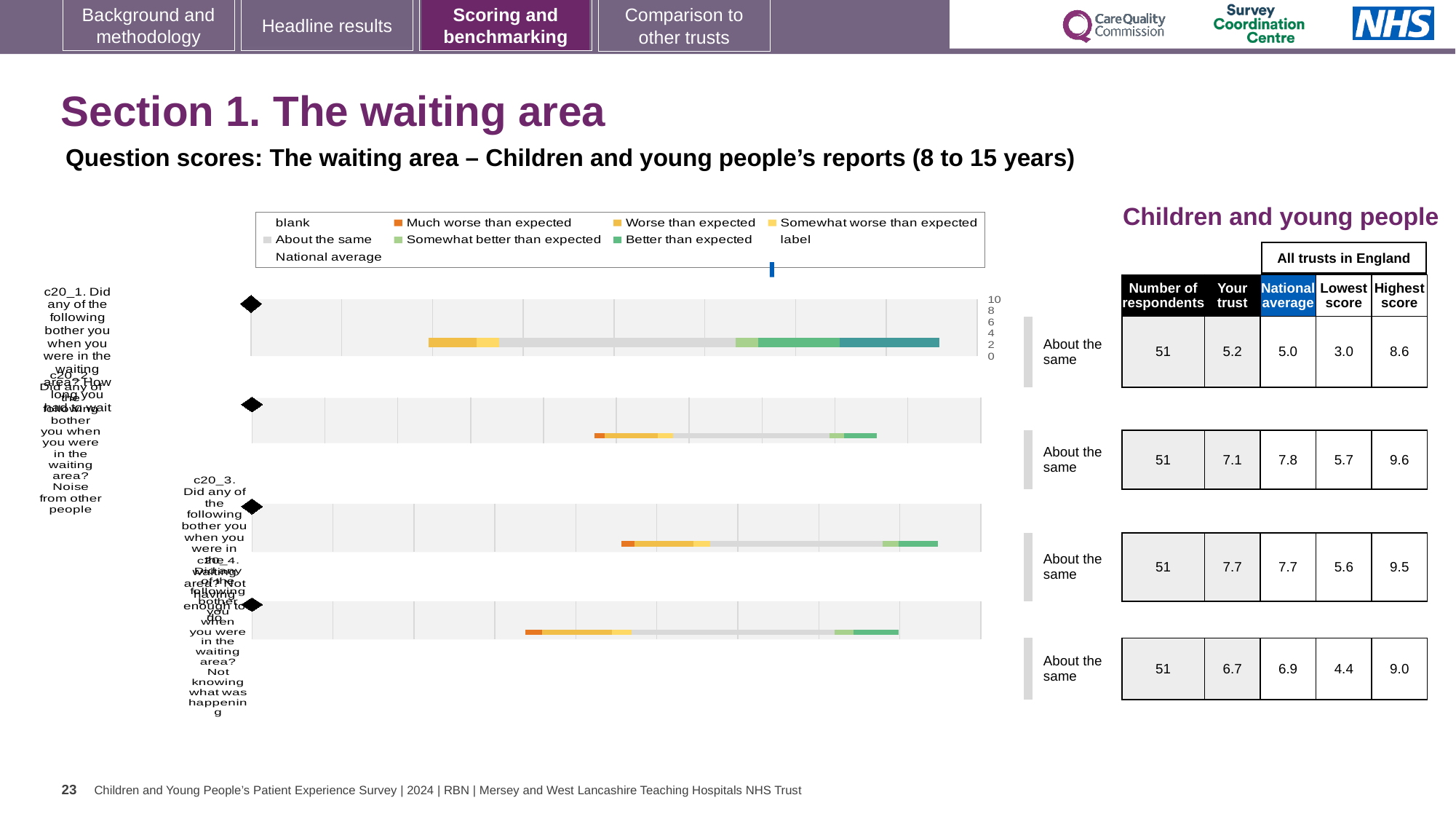
What is the national average score for question c20_2 (noise from other people)? 7.8 What is the highest score across all trusts in England for question c20_3 (not having enough to do)? 9.5 What benchmark label is shown next to the bar chart for question c20_1? About the same What kind of chart is used to show the benchmarking results for each waiting area question? bar chart What is the lowest score across all trusts in England for question c20_4 (not knowing what was happening)? 4.4 What is the 'Your trust' score for question c20_1 (bothered by how long you had to wait)? 5.2 In the legend, what colour represents 'Much worse than expected'? orange Which question has the lowest 'Your trust' score? c20_1 How many respondents answered question c20_1? 51 Which question has the highest 'Your trust' score? c20_3 For question c20_2, which is larger: the 'Your trust' score or the national average? national average How many separate bar charts (one per question) are shown on the slide? 4